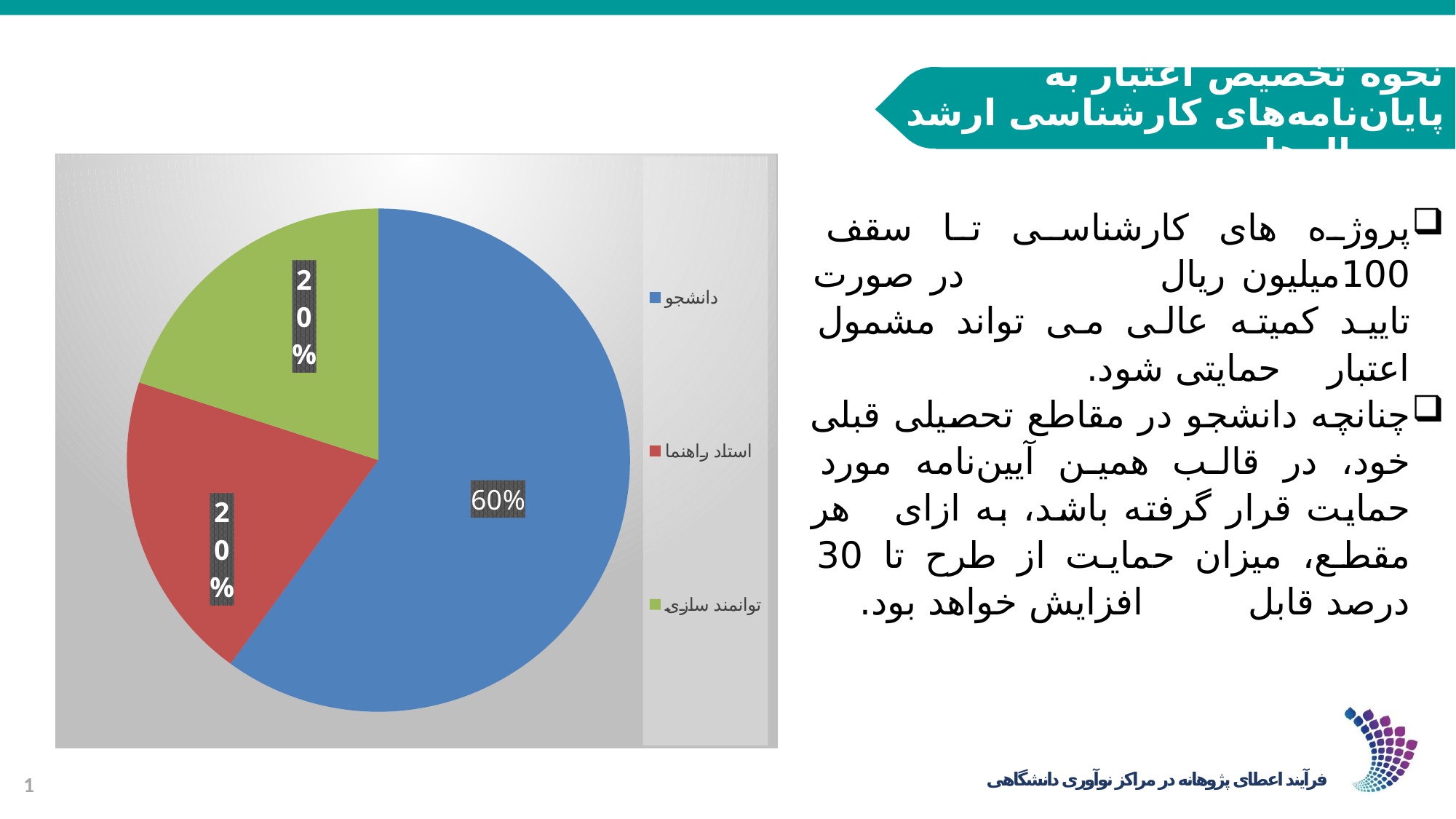
Is the value for دانشجو greater or less than 50%? greater What share of the pie does دانشجو represent? 60% Which category has the largest slice of the pie? دانشجو What colour is the slice for دانشجو? blue How many entries does the legend list? 3 What type of chart is shown on the slide? pie chart Which is larger, the slice for دانشجو or the slice for توانمند سازی? دانشجو What colour is the slice for استاد راهنما? red What is the value shown for استاد راهنما? 20% How many slices does the pie chart have? 3 What is the value shown for توانمند سازی? 20% What is the difference between the share for دانشجو and the share for استاد راهنما? 40%